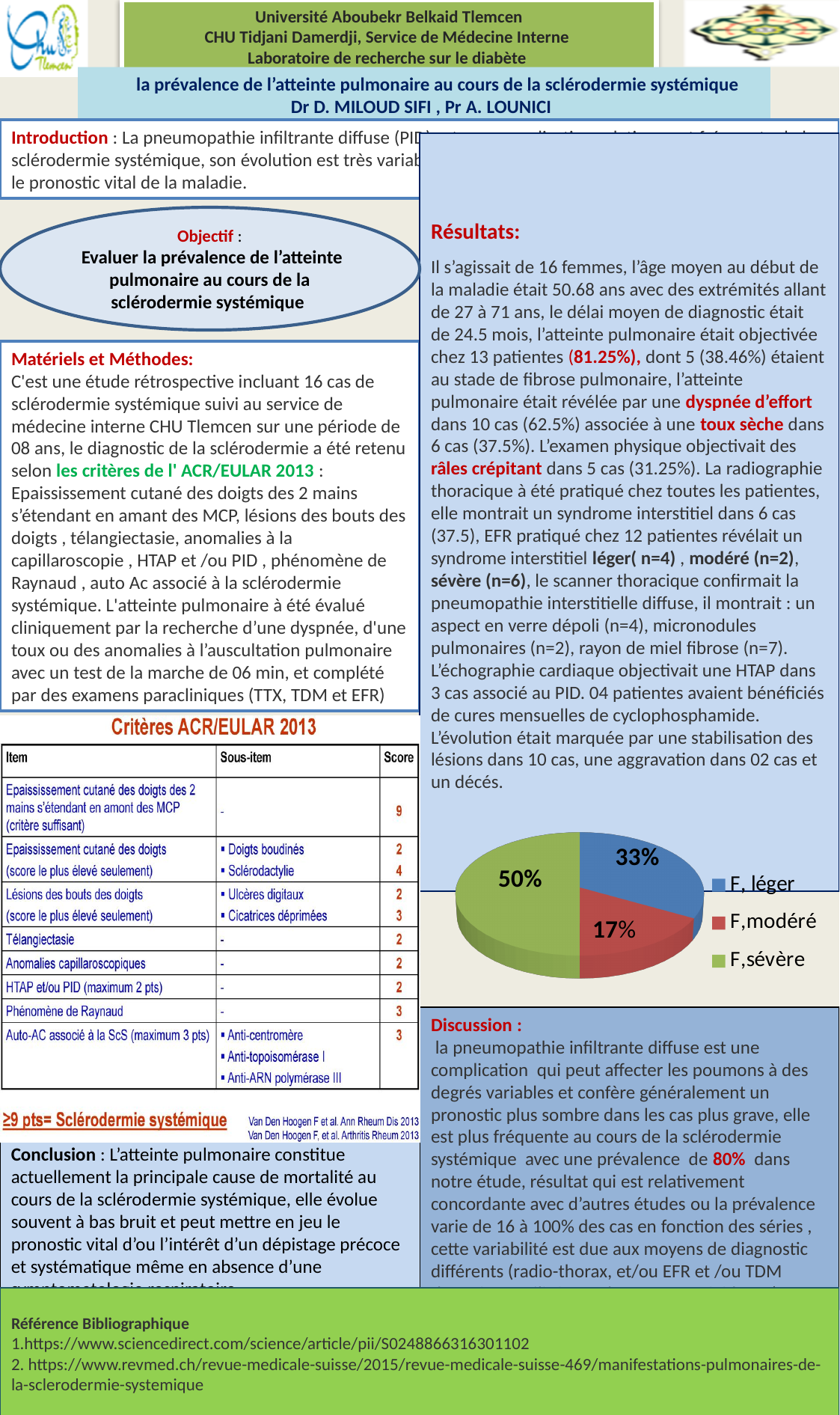
What colour is the F,sévère slice in the pie chart? green What is the difference in percentage points between the F,sévère slice and the F, léger slice? 17 Which category has the smallest slice in the pie chart? F,modéré How many slices does the pie chart have? 3 How many entries does the legend of the pie chart list? 3 What share of the pie chart does F,modéré represent? 17% What share of the pie chart does F,sévère represent? 50% What colour is the F,modéré slice in the pie chart? red What share of the pie chart does F, léger represent? 33% What kind of chart is shown on the slide? pie chart Which slice is larger in the pie chart, F, léger or F,modéré? F, léger Which category has the largest slice in the pie chart? F,sévère